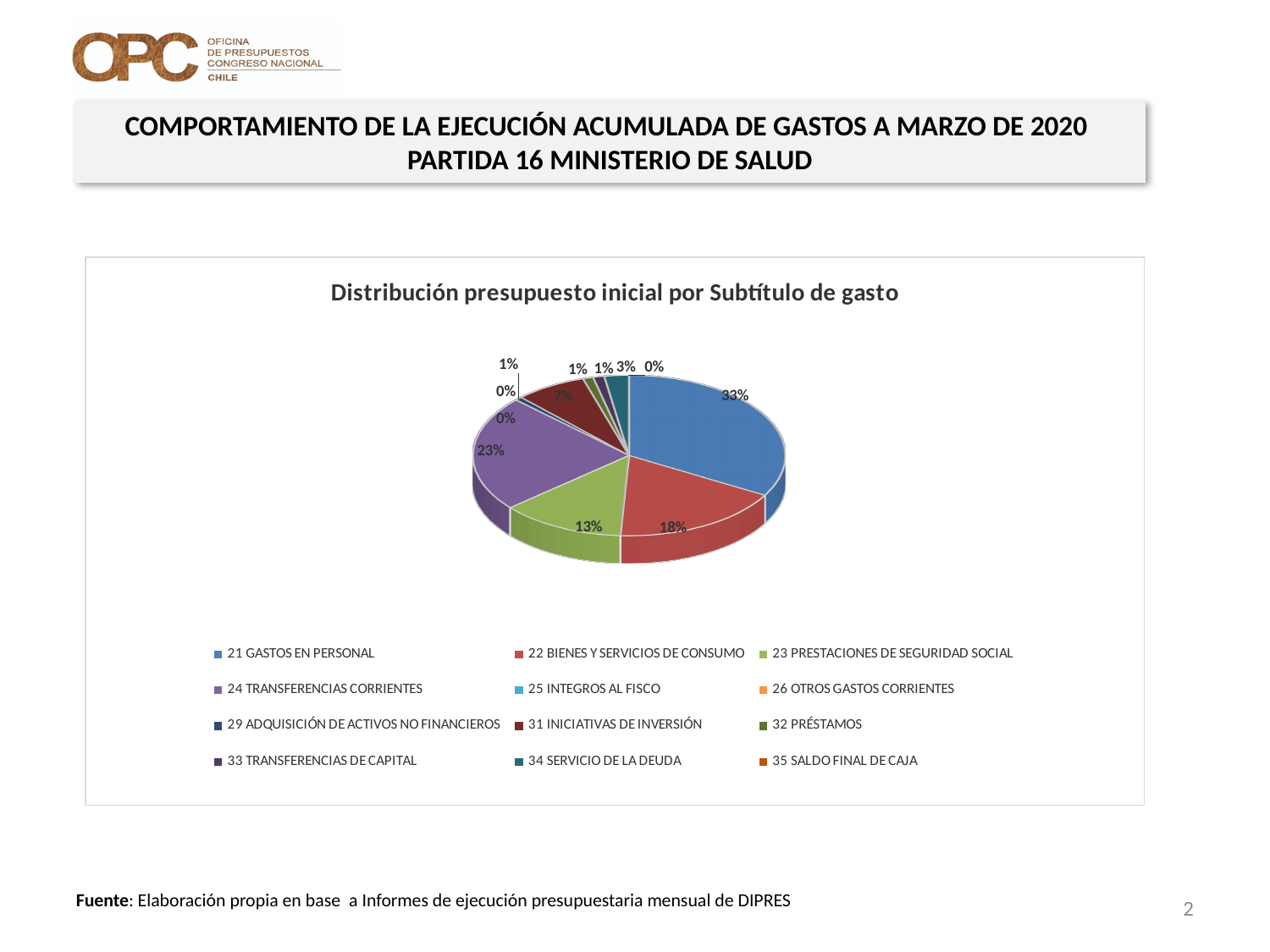
What share of the pie does 21 GASTOS EN PERSONAL represent? 33% Which is larger, the share for 22 BIENES Y SERVICIOS DE CONSUMO or the share for 24 TRANSFERENCIAS CORRIENTES? 24 TRANSFERENCIAS CORRIENTES Which category has the largest slice of the pie? 21 GASTOS EN PERSONAL What share of the pie does 24 TRANSFERENCIAS CORRIENTES represent? 23% How many categories does the legend of the pie chart list? 12 What share of the pie does 31 INICIATIVAS DE INVERSIÓN represent? 7% What is the difference in percentage points between the share for 21 GASTOS EN PERSONAL and the share for 24 TRANSFERENCIAS CORRIENTES? 10 percentage points What is the combined share of 21 GASTOS EN PERSONAL and 22 BIENES Y SERVICIOS DE CONSUMO? 51% What is the title of the chart? Distribución presupuesto inicial por Subtítulo de gasto What kind of chart is shown on the slide? Pie chart